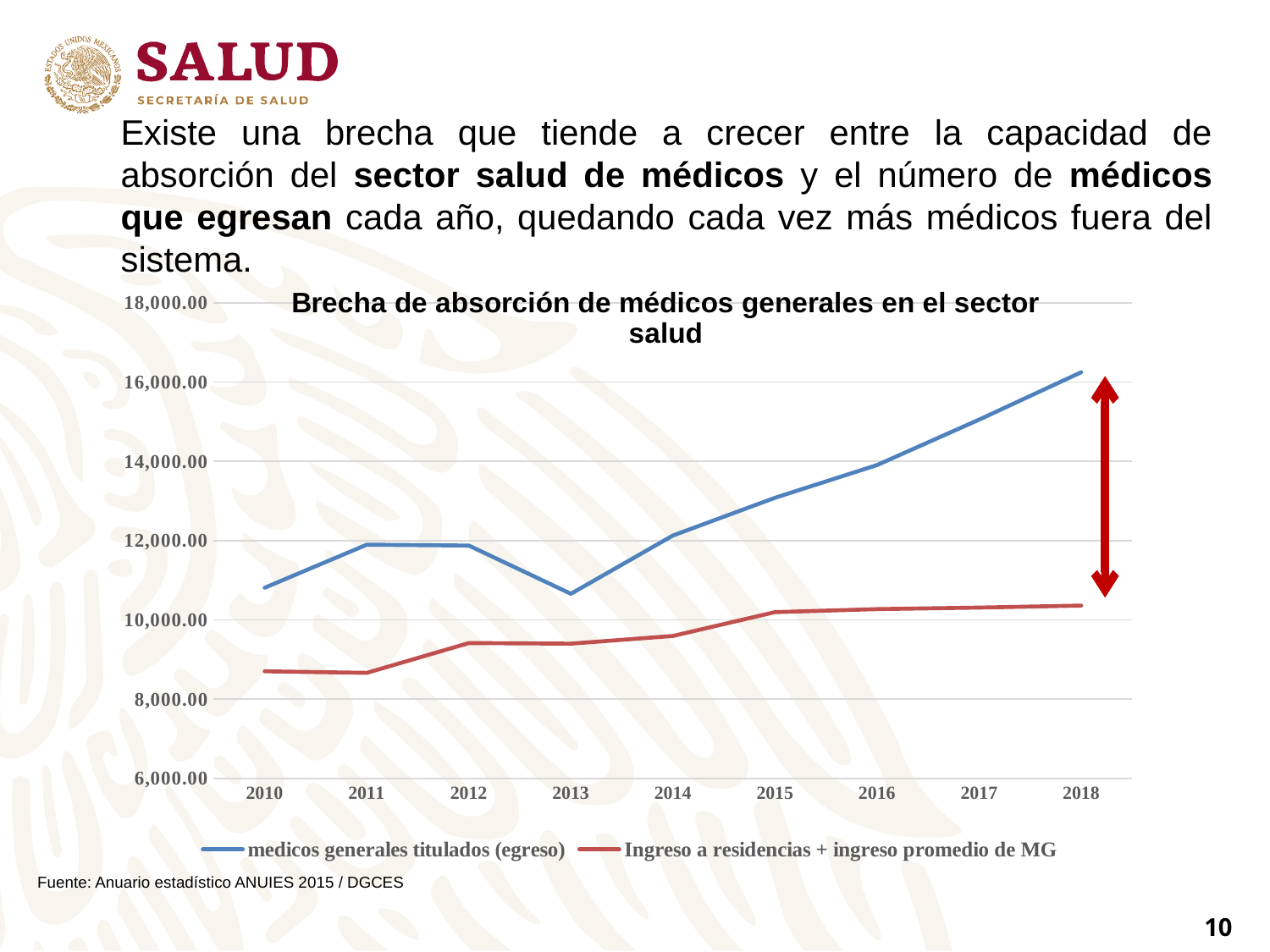
In which year does the 'medicos generales titulados (egreso)' series reach its highest value? 2018 What is the title of the chart? Brecha de absorción de médicos generales en el sector salud How many years are plotted along the x axis? 9 Does the 'medicos generales titulados (egreso)' series rise or fall from 2013 to 2018? rise Is the value for 'Ingreso a residencias + ingreso promedio de MG' in 2010 greater or less than 10,000.00? less In 2018, which series has the larger value: 'medicos generales titulados (egreso)' or 'Ingreso a residencias + ingreso promedio de MG'? medicos generales titulados (egreso) Is the value for 'medicos generales titulados (egreso)' in 2018 greater or less than 16,000.00? greater Is the value for 'Ingreso a residencias + ingreso promedio de MG' in 2012 greater or less than 10,000.00? less What kind of chart is shown on the slide? line chart Which series is drawn in blue? medicos generales titulados (egreso) How many series does the chart legend list? 2